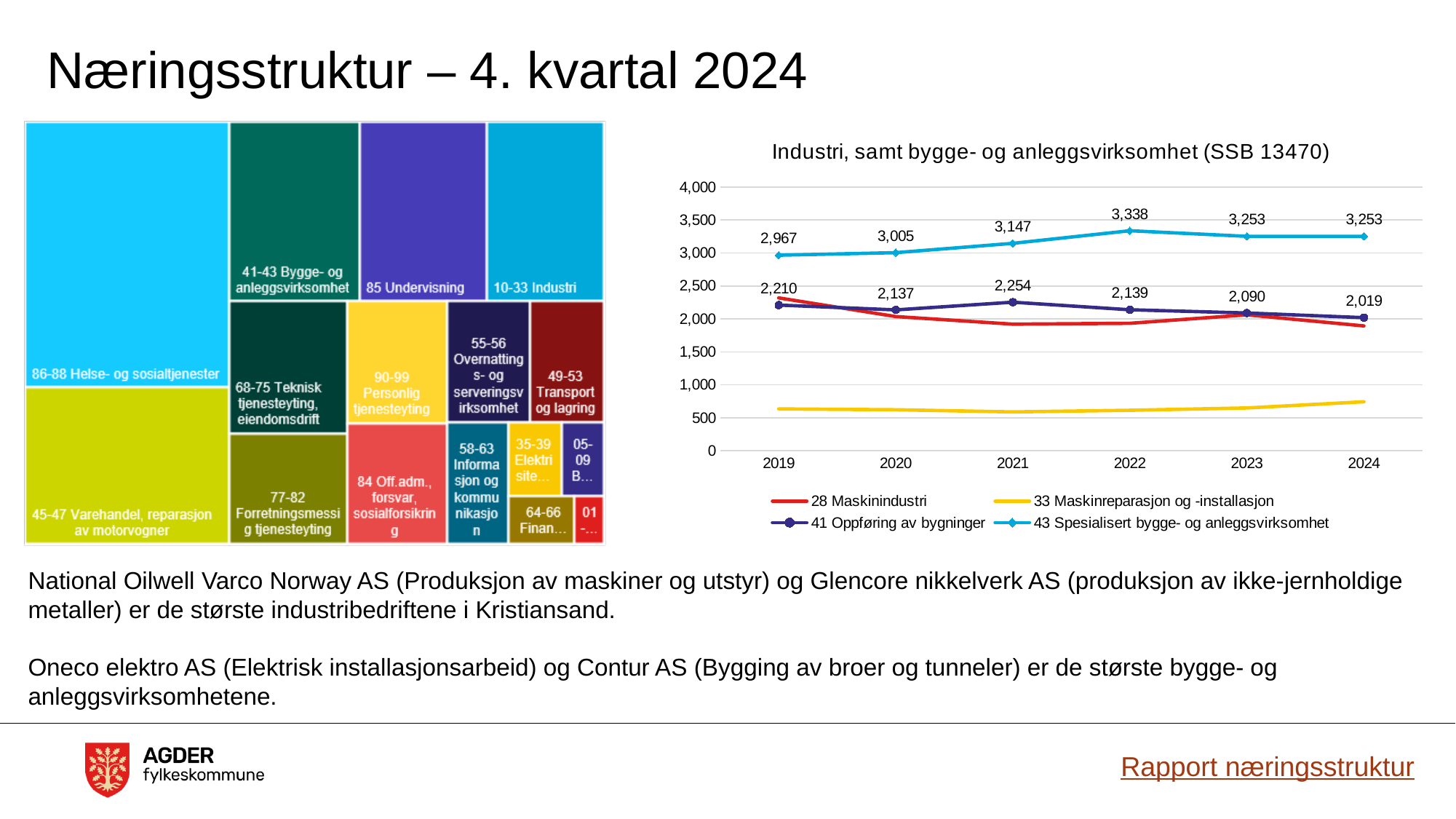
In the line chart 'Industri, samt bygge- og anleggsvirksomhet (SSB 13470)', how many series does the legend list? 4 In the line chart 'Industri, samt bygge- og anleggsvirksomhet (SSB 13470)', which series has the larger value in 2024: 43 Spesialisert bygge- og anleggsvirksomhet or 41 Oppføring av bygninger? 43 Spesialisert bygge- og anleggsvirksomhet In the line chart 'Industri, samt bygge- og anleggsvirksomhet (SSB 13470)', in which year is 43 Spesialisert bygge- og anleggsvirksomhet highest? 2022 In the line chart 'Industri, samt bygge- og anleggsvirksomhet (SSB 13470)', in which year is 41 Oppføring av bygninger lowest? 2024 In the line chart 'Industri, samt bygge- og anleggsvirksomhet (SSB 13470)', what is the value for 43 Spesialisert bygge- og anleggsvirksomhet in 2022? 3,338 In the line chart 'Industri, samt bygge- og anleggsvirksomhet (SSB 13470)', what is the difference between the 2022 and 2019 values for 43 Spesialisert bygge- og anleggsvirksomhet? 371 In the line chart 'Industri, samt bygge- og anleggsvirksomhet (SSB 13470)', what is the value for 41 Oppføring av bygninger in 2024? 2,019 In the line chart 'Industri, samt bygge- og anleggsvirksomhet (SSB 13470)', how many years are shown on the x axis? 6 In the treemap on the left of the slide, which category occupies the largest area? 86-88 Helse- og sosialtjenester In the line chart 'Industri, samt bygge- og anleggsvirksomhet (SSB 13470)', what is the difference between the 2021 and 2024 values for 41 Oppføring av bygninger? 235 What kind of chart is the chart titled 'Industri, samt bygge- og anleggsvirksomhet (SSB 13470)'? Line chart In the line chart 'Industri, samt bygge- og anleggsvirksomhet (SSB 13470)', is the value for 33 Maskinreparasjon og -installasjon in 2024 greater or less than 1,000? less